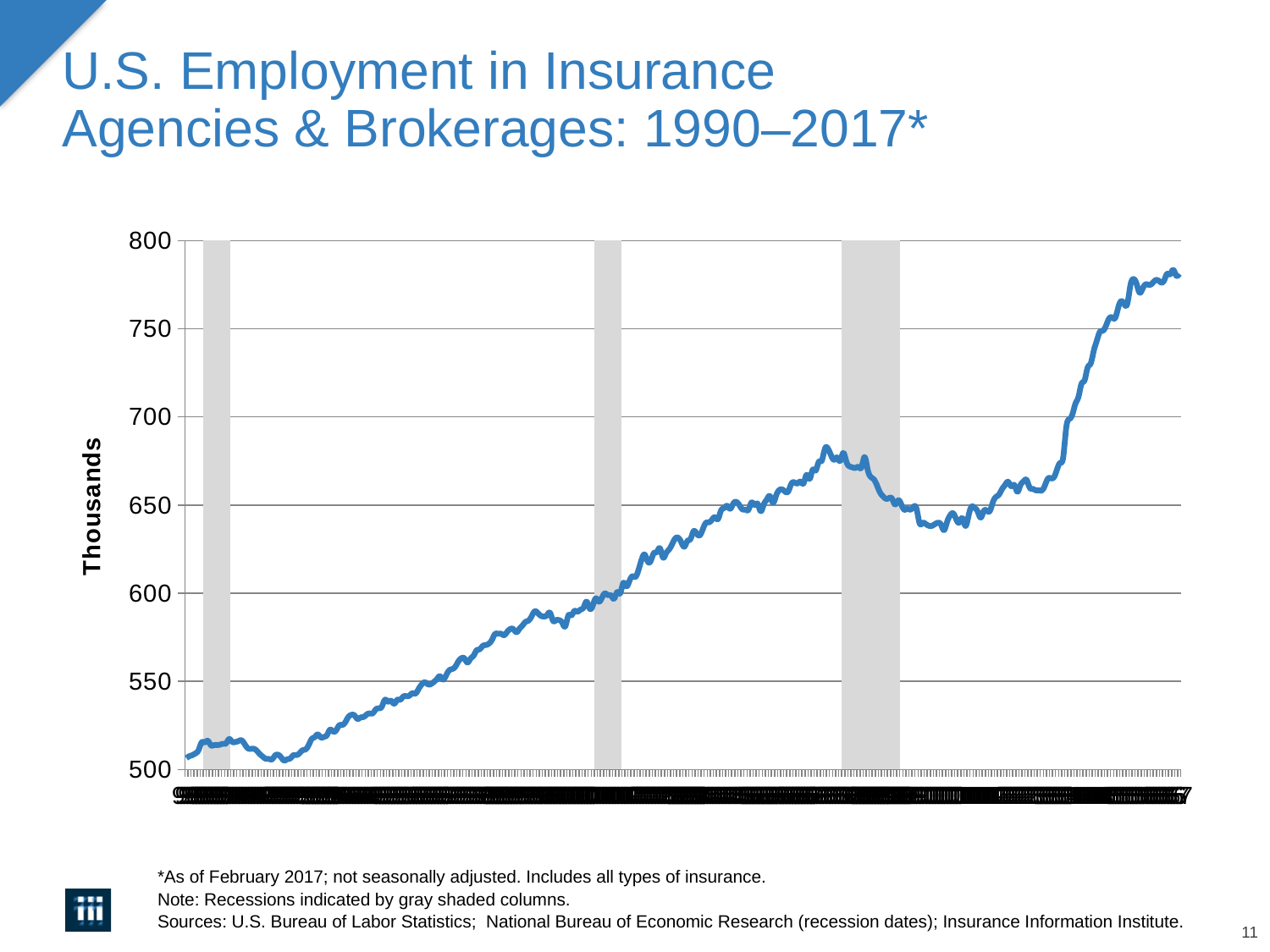
Is the value at the end of the series (far right) greater or less than 750? greater Is the peak reached just before the third gray shaded column greater or less than 650? greater Is the value at the end of the series higher or lower than the value at the start of the series? higher According to the note on the slide, what do the gray shaded columns indicate? Recessions How many gray shaded columns appear on the chart? 3 What kind of chart is shown on the slide? Line chart Is the lowest point reached after the third gray shaded column greater or less than 650? less Is the peak just before the third gray shaded column higher or lower than the value at the far right of the chart? lower Overall, do the values rise or fall from the left of the x axis to the right? Rise What is the label on the vertical axis of the chart? Thousands